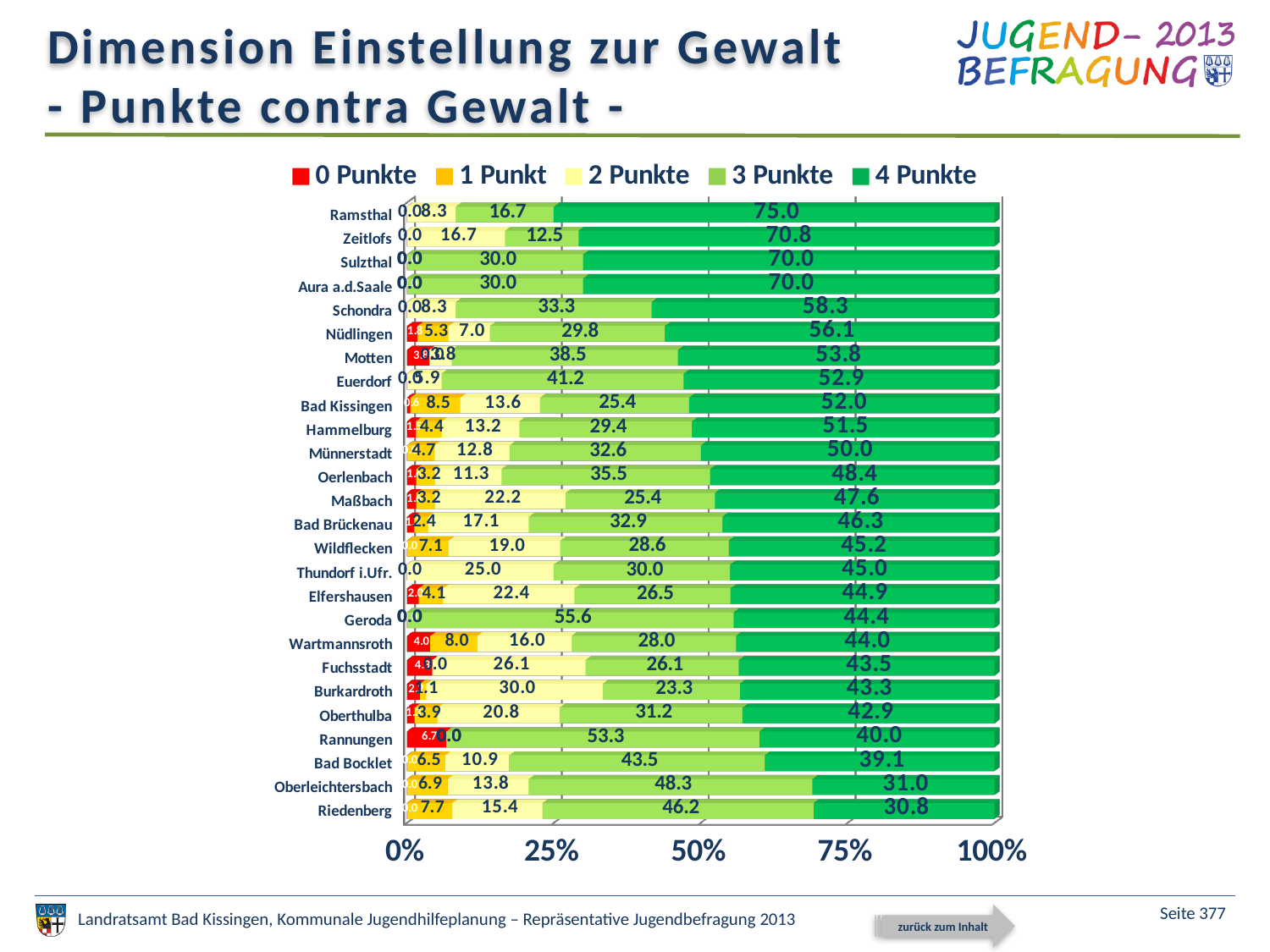
Which municipality has the highest 4 Punkte value? Ramsthal What is the value of the 3 Punkte segment for Geroda? 55.6 Is the 4 Punkte value for Zeitlofs greater or less than 50%? greater What is the value of the 2 Punkte segment for Sulzthal? 0.0 Which municipality has the lowest 4 Punkte value? Riedenberg How many series does the legend list? 5 What kind of chart is shown on the slide? Stacked bar chart Which has the larger 3 Punkte value, Rannungen or Geroda? Geroda What is the value of the 4 Punkte segment for Ramsthal? 75.0 What is the difference between the 4 Punkte values of Ramsthal and Riedenberg? 44.2 What is the value of the 3 Punkte segment for Riedenberg? 46.2 How many municipalities are shown on the chart? 26